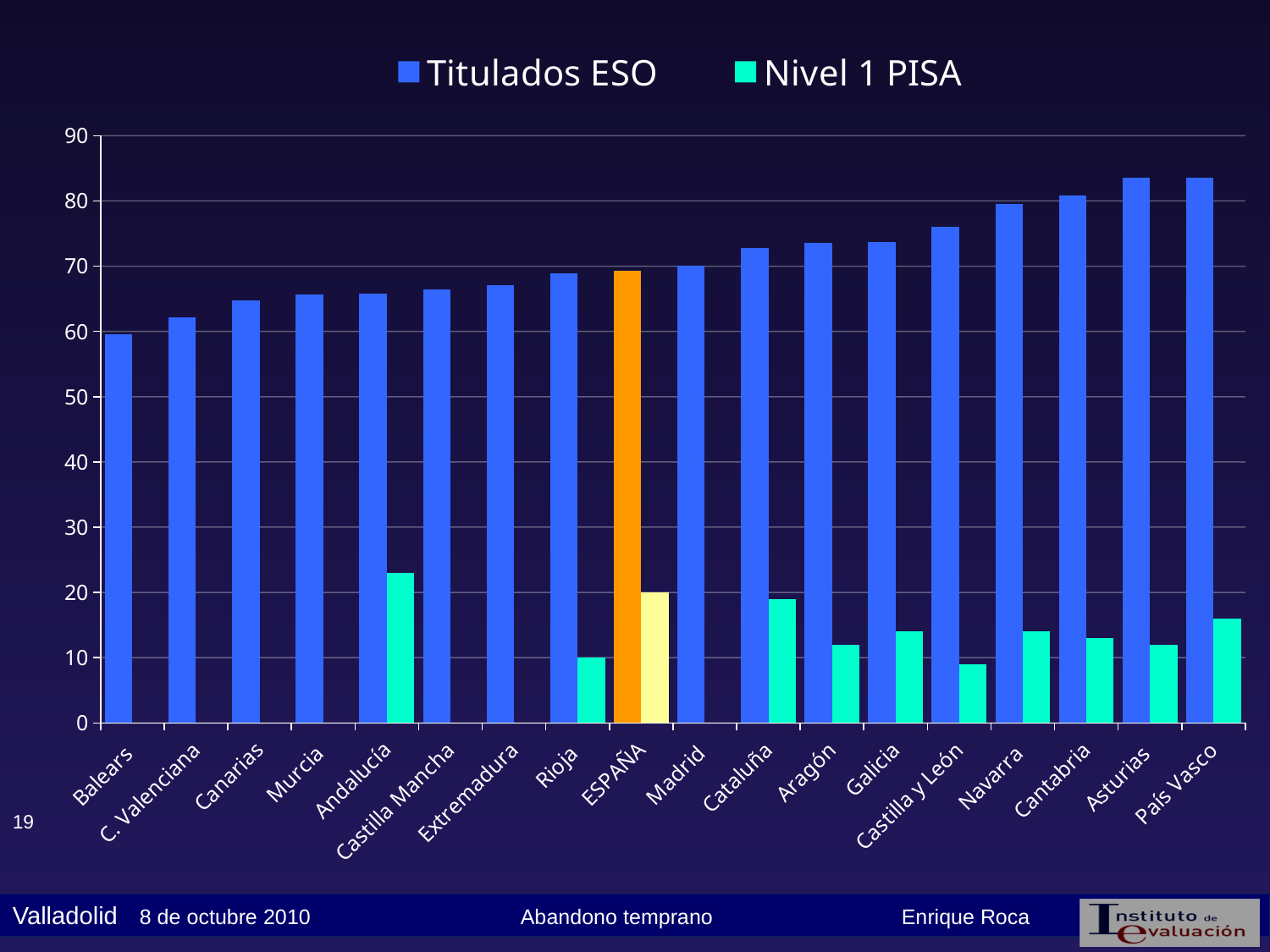
Which category's bars are drawn in a different colour (orange and pale yellow) from the rest? ESPAÑA Is the Titulados ESO value for Castilla y León greater or less than 70? greater Which category has the highest value for Nivel 1 PISA? Andalucía Do the Titulados ESO values generally rise or fall from left to right along the x axis? rise Is the Nivel 1 PISA value for Andalucía greater or less than 20? greater What kind of chart is shown on the slide? bar chart How many series does the legend list? 2 Is the Nivel 1 PISA value for Galicia greater or less than 10? greater How many categories are shown along the x axis? 18 Which category has the lowest value for Titulados ESO? Balears Which has the larger Titulados ESO value, Balears or País Vasco? País Vasco